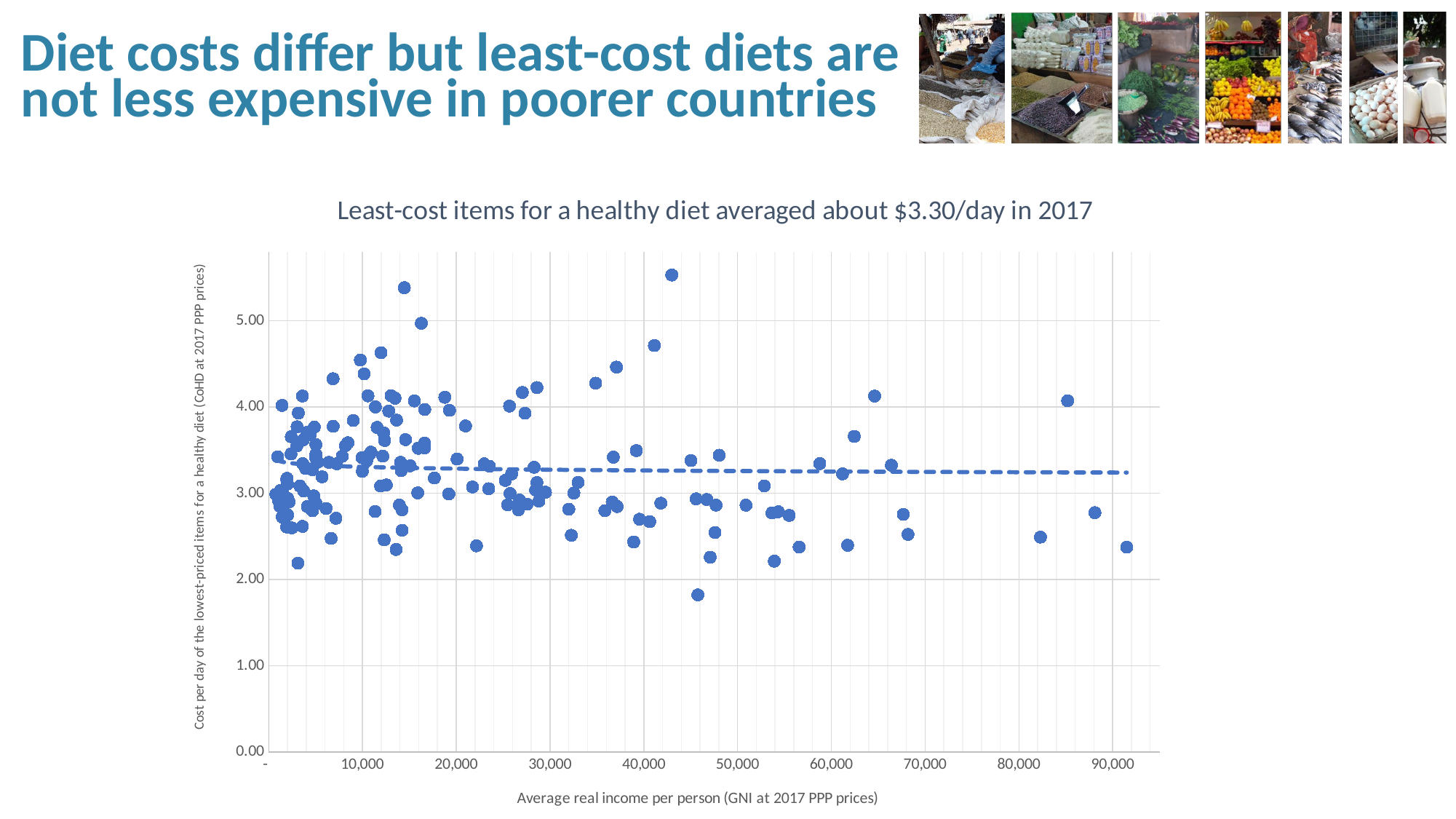
Is the point plotted at roughly 85,000 on the x axis greater or less than 4.00 on the y axis? greater Is the point plotted at roughly 43,000 on the x axis greater or less than 5.00 on the y axis? greater What is the title of the chart? Least-cost items for a healthy diet averaged about $3.30/day in 2017 What does the x axis of the chart represent? Average real income per person (GNI at 2017 PPP prices) Is the point plotted at roughly 90,000 on the x axis greater or less than 3.00 on the y axis? less Does the dashed trend line rise steeply, fall steeply, or stay roughly flat as income increases along the x axis? Roughly flat What is the highest value labelled on the y axis? 5.00 What kind of chart is shown on the slide? Scatter plot